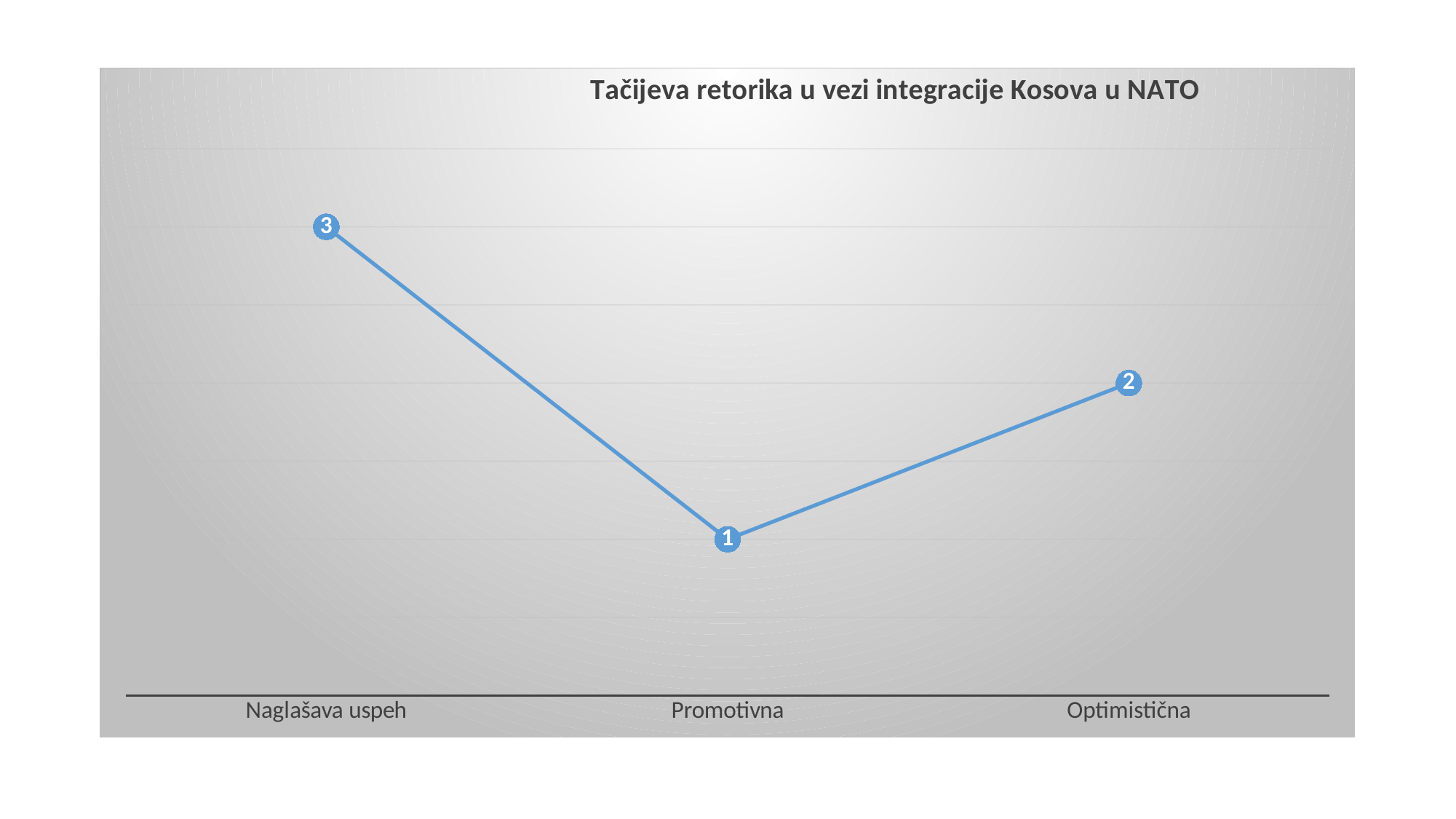
What is the value for Optimistična? 2 Which is larger, the value for Naglašava uspeh or the value for Optimistična? Naglašava uspeh What is the difference between the values for Naglašava uspeh and Promotivna? 2 What kind of chart is this? line chart What is the title of the chart? Tačijeva retorika u vezi integracije Kosova u NATO What is the value for Promotivna? 1 What is the value for Naglašava uspeh? 3 How many categories are shown on the x axis? 3 Which category has the lowest value? Promotivna Which category has the highest value? Naglašava uspeh Does the value rise or fall from Promotivna to Optimistična? rise What is the difference between the values for Optimistična and Promotivna? 1